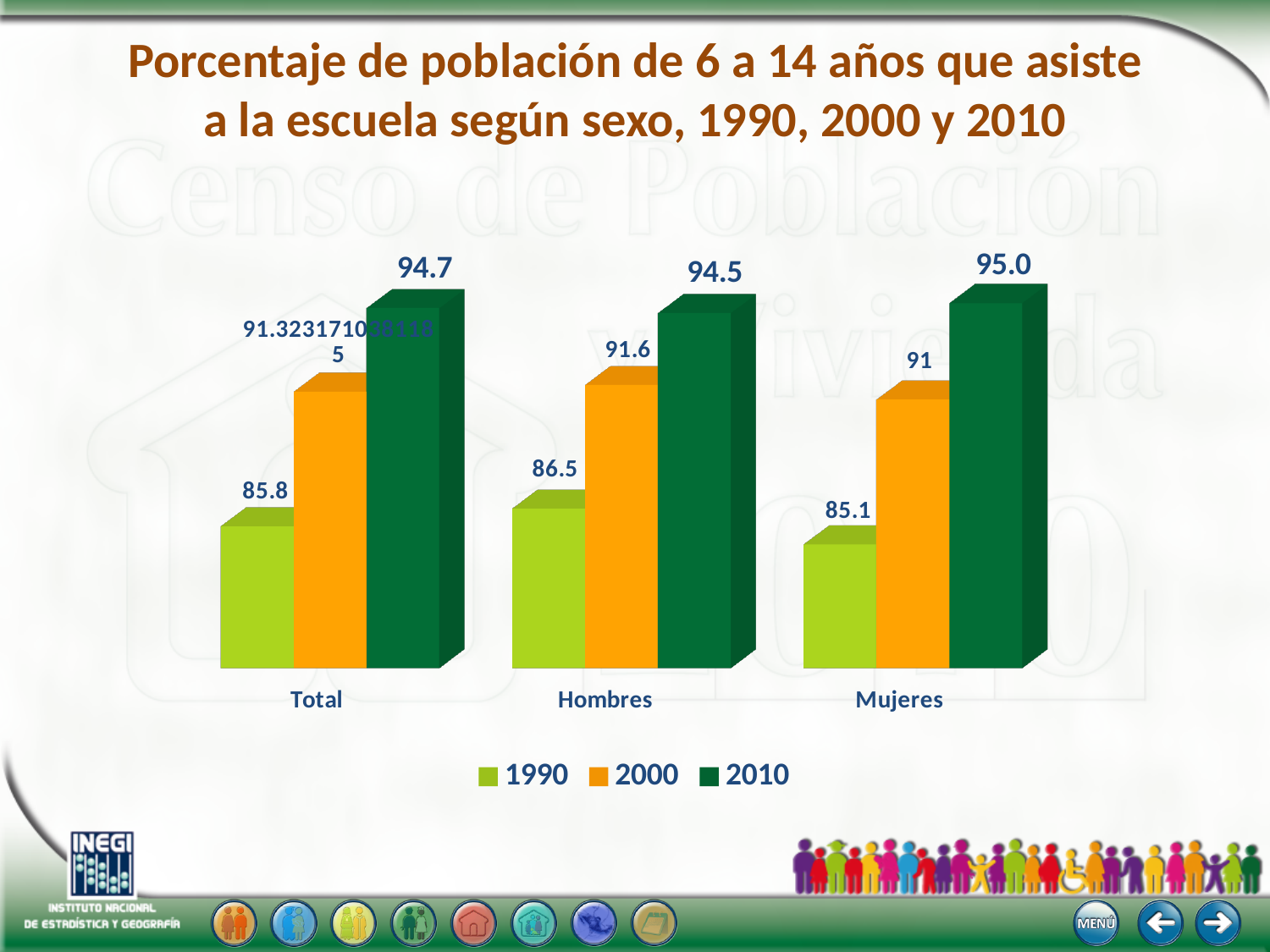
What is the value for Total in 2010? 94.7 What is the value for Hombres in 2000? 91.6 What is the value for Mujeres in 2000? 91 How many series does the legend list? 3 What kind of chart is shown on the slide? Bar chart What is the value for Hombres in 2010? 94.5 What is the difference between the 2010 and 1990 values for Mujeres? 9.9 What is the difference between the 2010 and 1990 values for Hombres? 8.0 Which category has the lowest value in 1990? Mujeres What is the value for Mujeres in 1990? 85.1 Which category has the highest value in 2010? Mujeres Which is larger: the 1990 value for Hombres or the 1990 value for Total? Hombres